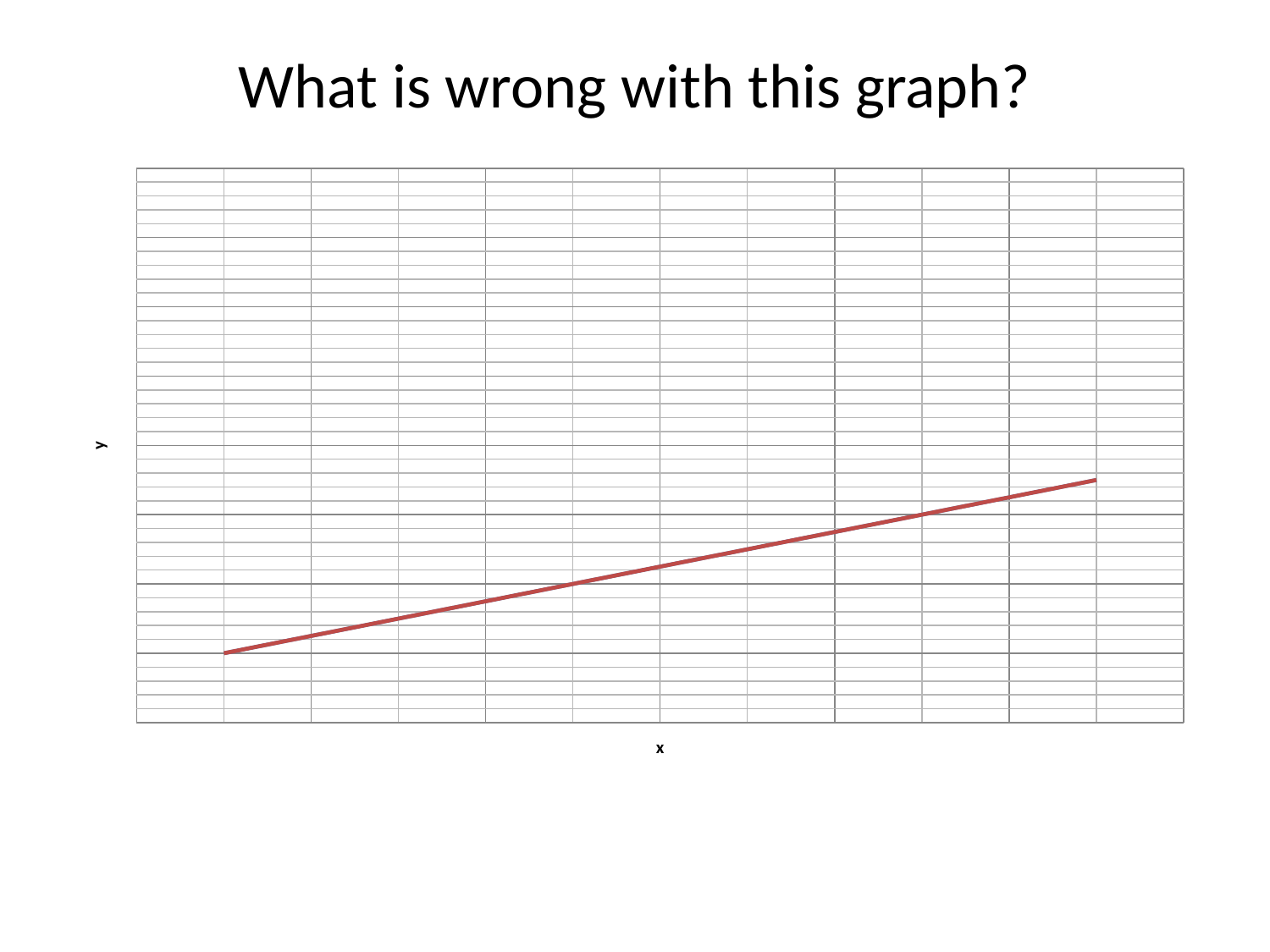
What is the label on the horizontal axis of the chart? x Does the plotted line rise or fall as x increases? rises What is the label on the vertical axis of the chart? y What kind of chart is shown on the slide? line chart